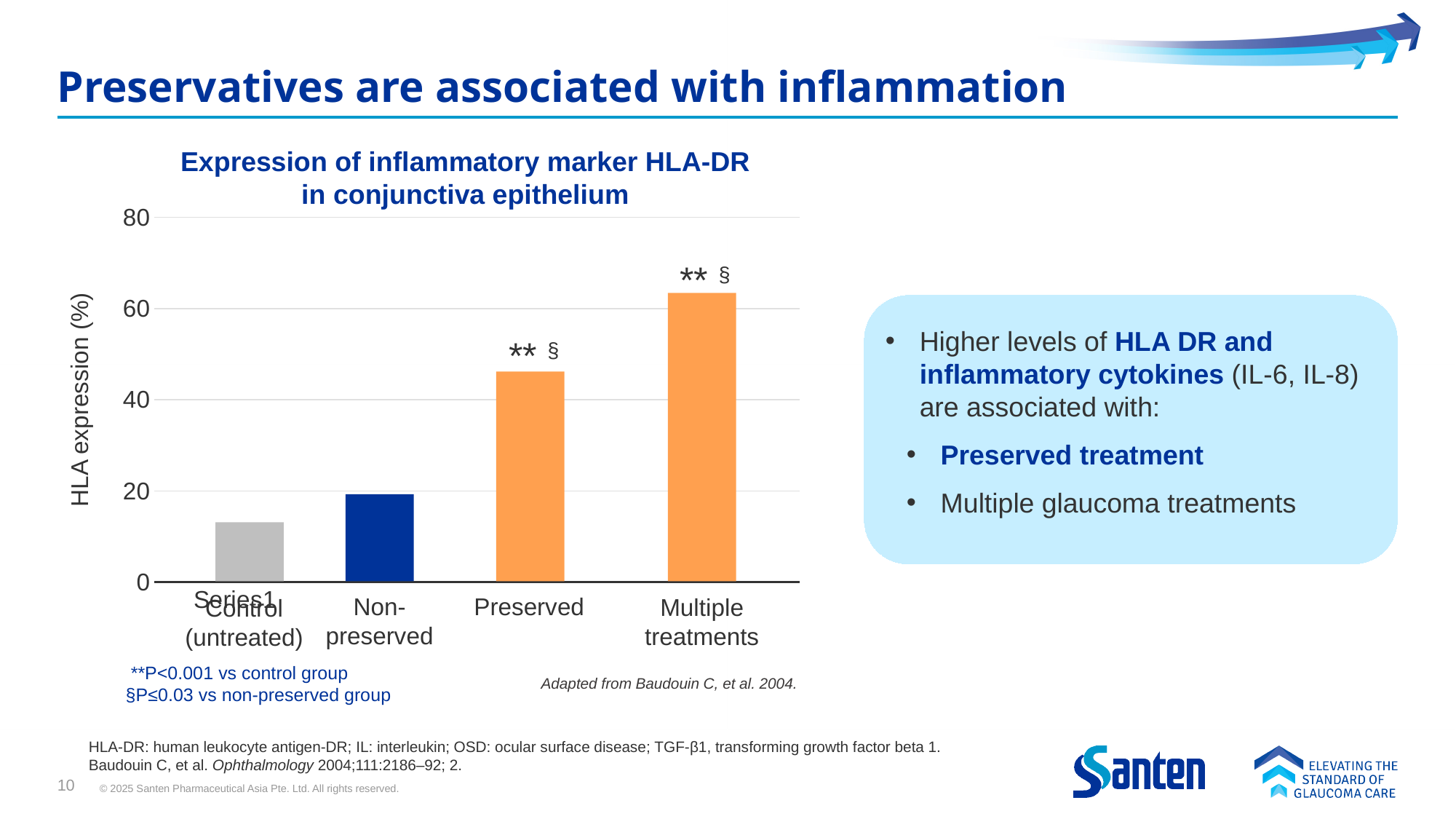
Do the bar values rise or fall from left to right across the categories? rise How many categories (bars) are plotted in the chart? 4 Is the HLA expression for Control (untreated) greater or less than 20? less Which category has the lowest HLA expression? Control (untreated) What kind of chart is shown on the slide? bar chart Is the HLA expression for Preserved greater or less than 60? less Which has a higher HLA expression, Preserved or Non-preserved? Preserved Is the HLA expression for Preserved greater or less than 40? greater What is the title of the chart? Expression of inflammatory marker HLA-DR in conjunctiva epithelium What is the label of the y axis? HLA expression (%) Which category has the highest HLA expression? Multiple treatments